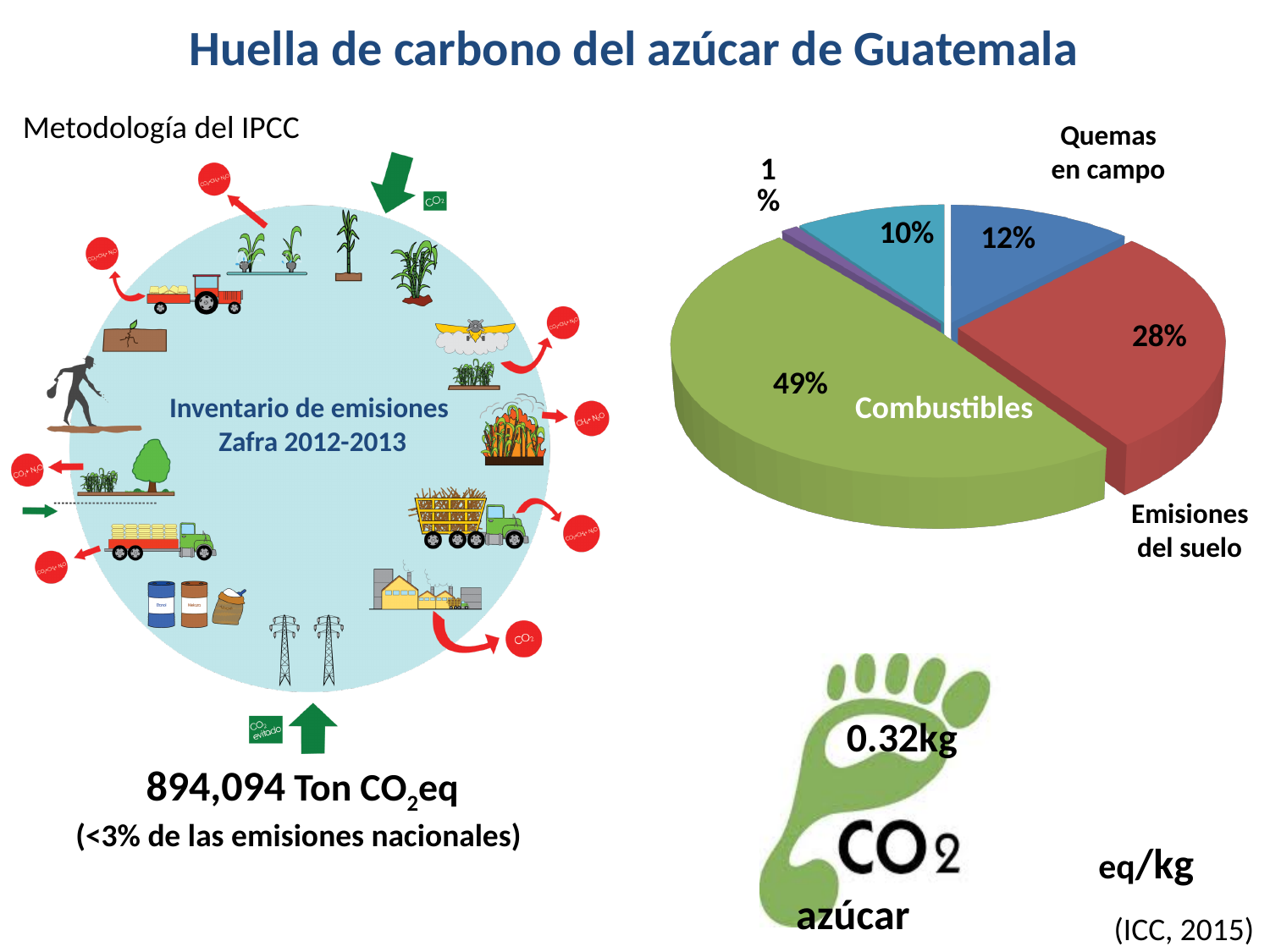
What colour is the Emisiones del suelo slice in the pie chart? red What percentage is shown for Emisiones del suelo in the pie chart? 28% What percentage of emissions does the Combustibles slice represent in the pie chart? 49% What is the smallest percentage shown on any slice of the pie chart? 1% What is the difference in percentage points between the Emisiones del suelo slice and the Quemas en campo slice? 16% How many slices does the pie chart have? 5 What percentage is shown for Quemas en campo in the pie chart? 12% Which slice is larger in the pie chart, Quemas en campo or Emisiones del suelo? Emisiones del suelo What colour is the Combustibles slice in the pie chart? green What is the difference in percentage points between the Combustibles slice and the Emisiones del suelo slice? 21% Which category has the largest slice in the pie chart? Combustibles What kind of chart is shown on the right side of the slide? pie chart